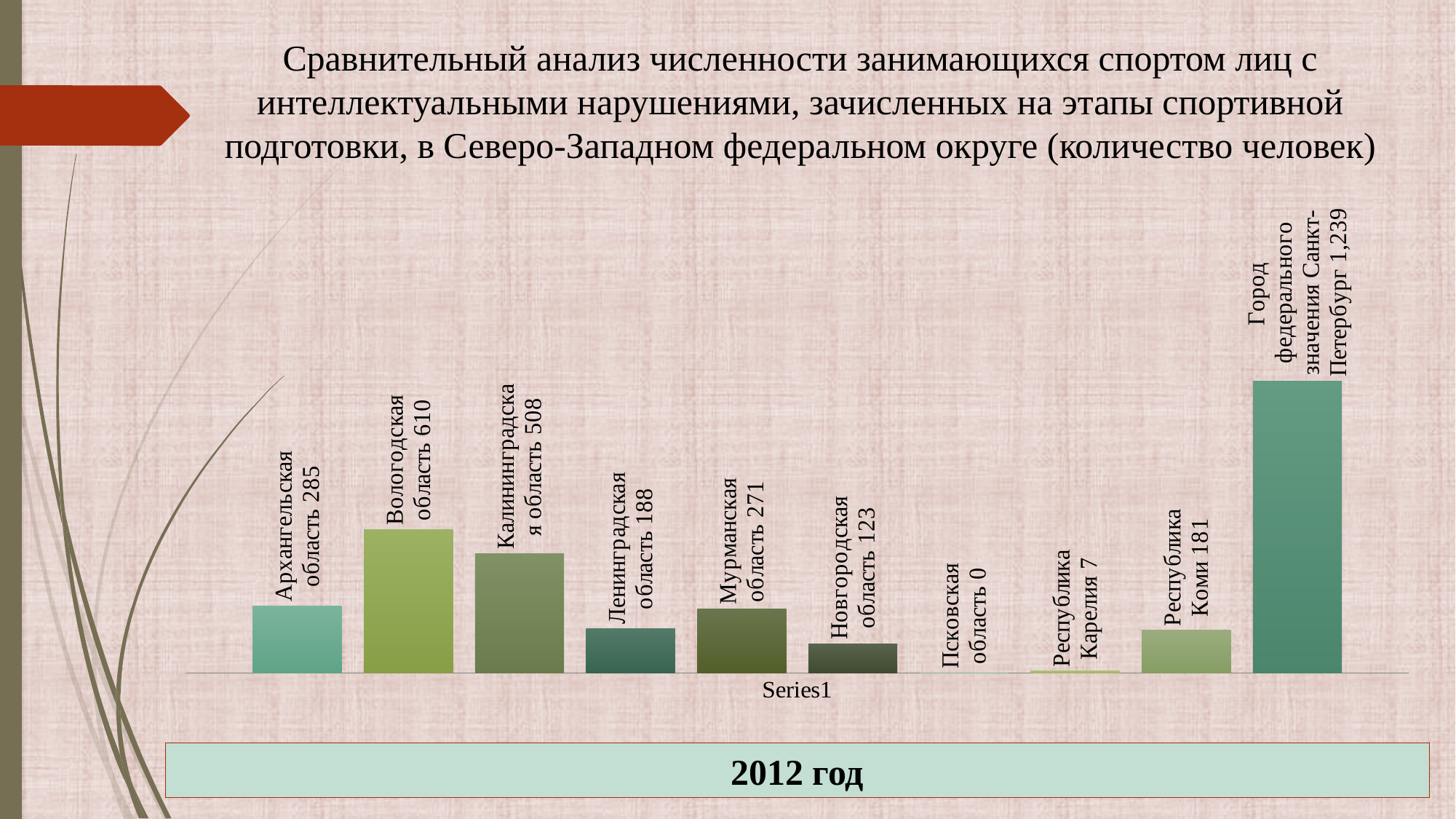
What is the value for Новгородская область? 123 Which region has the lowest value? Псковская область How many regions are shown in the chart? 10 Which is larger, the value for Мурманская область or the value for Архангельская область? Архангельская область What is the difference between the values for Ленинградская область and Республика Коми? 7 What year is indicated in the box below the chart? 2012 год What is the difference between the values for Вологодская область and Калининградская область? 102 What is the value for Республика Карелия? 7 What is the value for Город федерального значения Санкт-Петербург? 1,239 What kind of chart is shown on the slide? Bar chart Which region has the highest value? Город федерального значения Санкт-Петербург What is the value for Вологодская область? 610